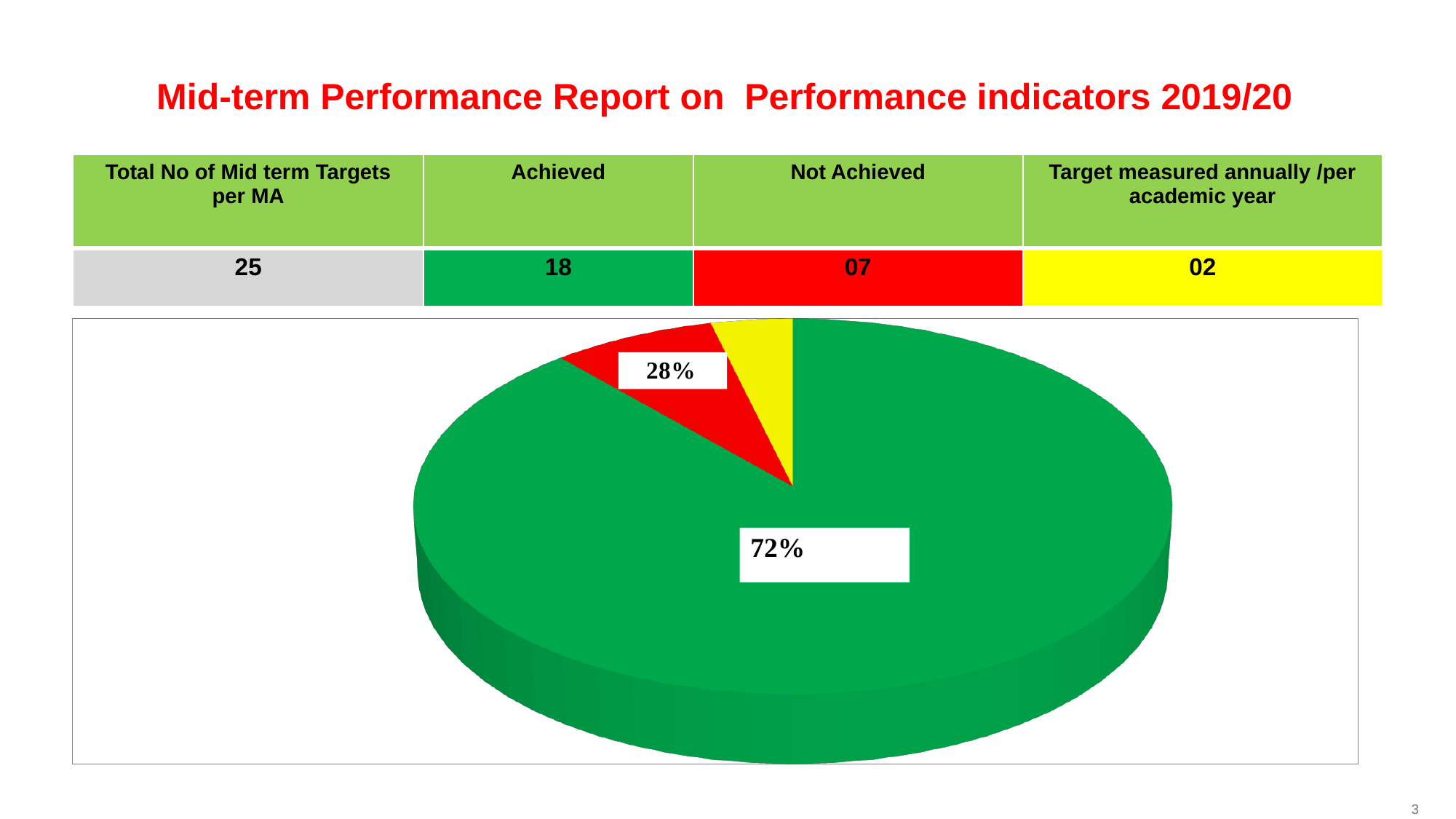
Which colour slice is the largest in the pie chart? green Does the pie chart include a legend? No What is the difference in percentage points between the green slice (72%) and the red slice (28%)? 44 What share of the pie does the green slice represent? 72% Is the green slice's share of the pie greater or less than 50%? greater Which colour slice is the smallest in the pie chart? yellow What percentage is printed on the red slice of the pie chart? 28% What kind of chart is shown on the slide? pie chart Which is larger in the pie chart, the green slice or the red slice? green What colour is the slice that has no percentage label in the pie chart? yellow What percentage is printed on the green slice of the pie chart? 72% How many slices does the pie chart have? 3